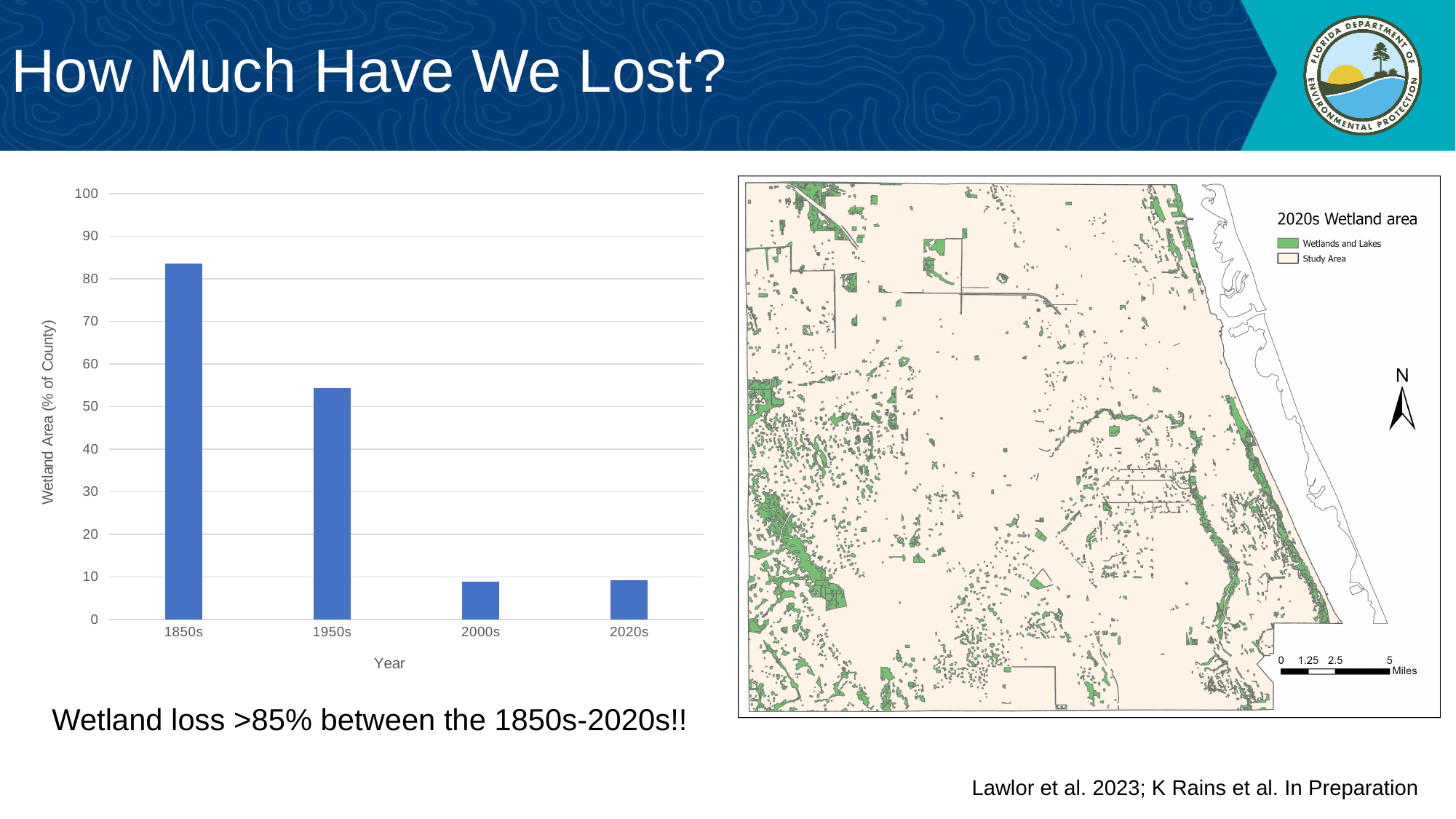
Which year category has the highest wetland area on the bar chart? 1850s Do the values on the bar chart generally rise or fall from the 1850s to the 2020s? fall What is the label of the vertical axis on the bar chart? Wetland Area (% of County) Is the wetland area for the 1950s greater or less than 50? greater Which has a larger wetland area on the bar chart, the 1850s or the 1950s? 1850s How many year categories are plotted on the bar chart? 4 Which has a larger wetland area on the bar chart, the 1950s or the 2000s? 1950s What kind of chart is shown on the left of the slide? bar chart Is the wetland area for the 1850s greater or less than 80? greater Is the wetland area for the 2020s greater or less than 20? less What is the label of the horizontal axis on the bar chart? Year